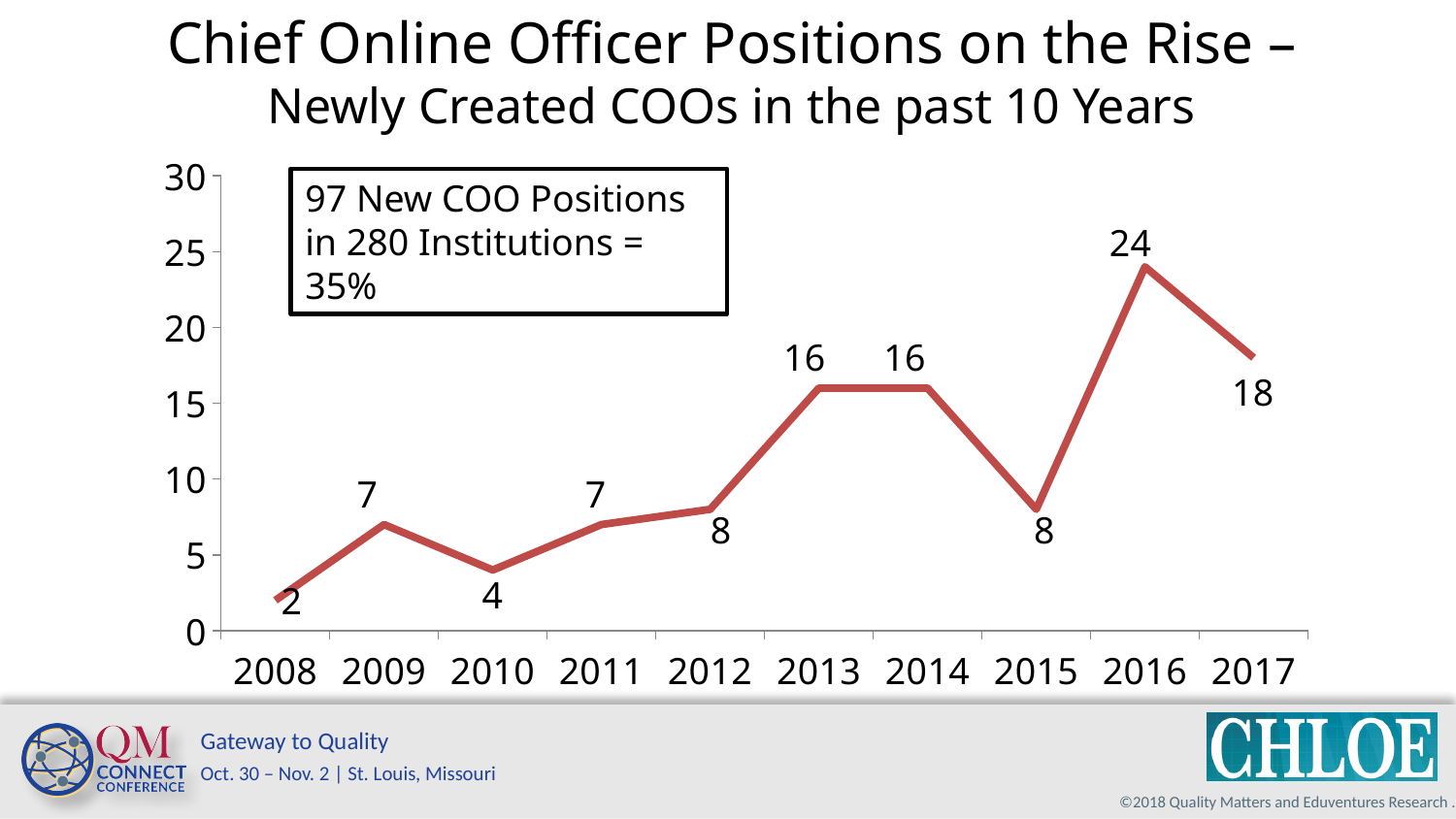
Which is larger, the value for 2012 or the value for 2015? They are equal (8) Is the value for 2016 greater or less than 20? greater Which year has the lowest value? 2008 Which year has the highest value? 2016 What is the value for 2016? 24 What does the text box on the chart say? 97 New COO Positions in 280 Institutions = 35% How many years are plotted on the x axis? 10 What is the difference between the values for 2016 and 2017? 6 What is the value for 2008? 2 Which is larger, the value for 2010 or the value for 2011? 2011 What kind of chart is shown? Line chart What is the value for 2013? 16